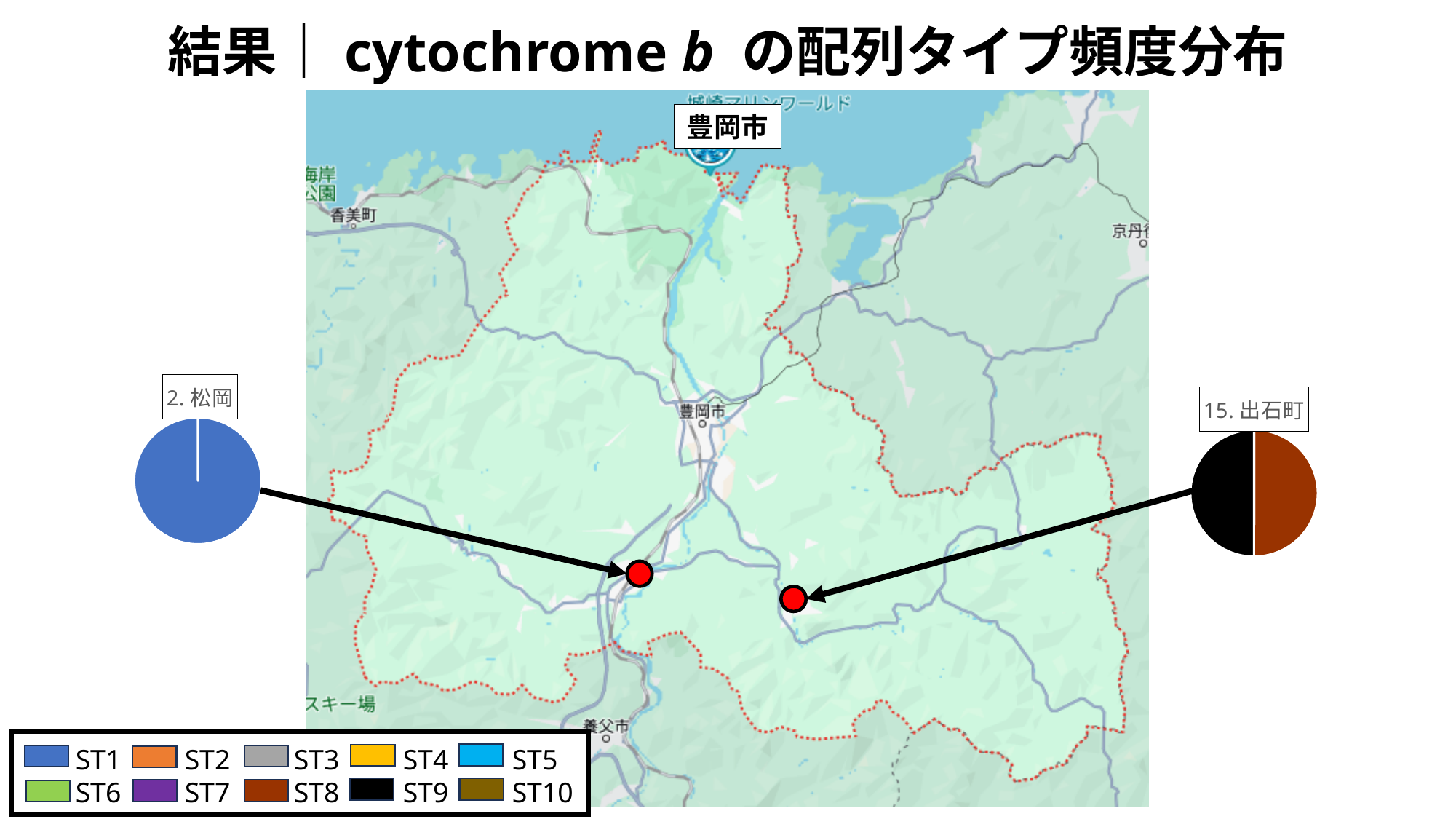
How many pie charts are shown on the map? 2 How many slices does the "2. 松岡" pie chart have? 1 How many slices does the "15. 出石町" pie chart have? 2 What colour represents ST9 in the legend? black What colour represents ST8 in the legend? brown What kind of chart is used for "2. 松岡"? pie chart What kind of chart is used for "15. 出石町"? pie chart How many sequence types does the legend list? 10 Which sequence type makes up the entire "2. 松岡" pie chart? ST1 Which two sequence types appear in the "15. 出石町" pie chart? ST8 and ST9